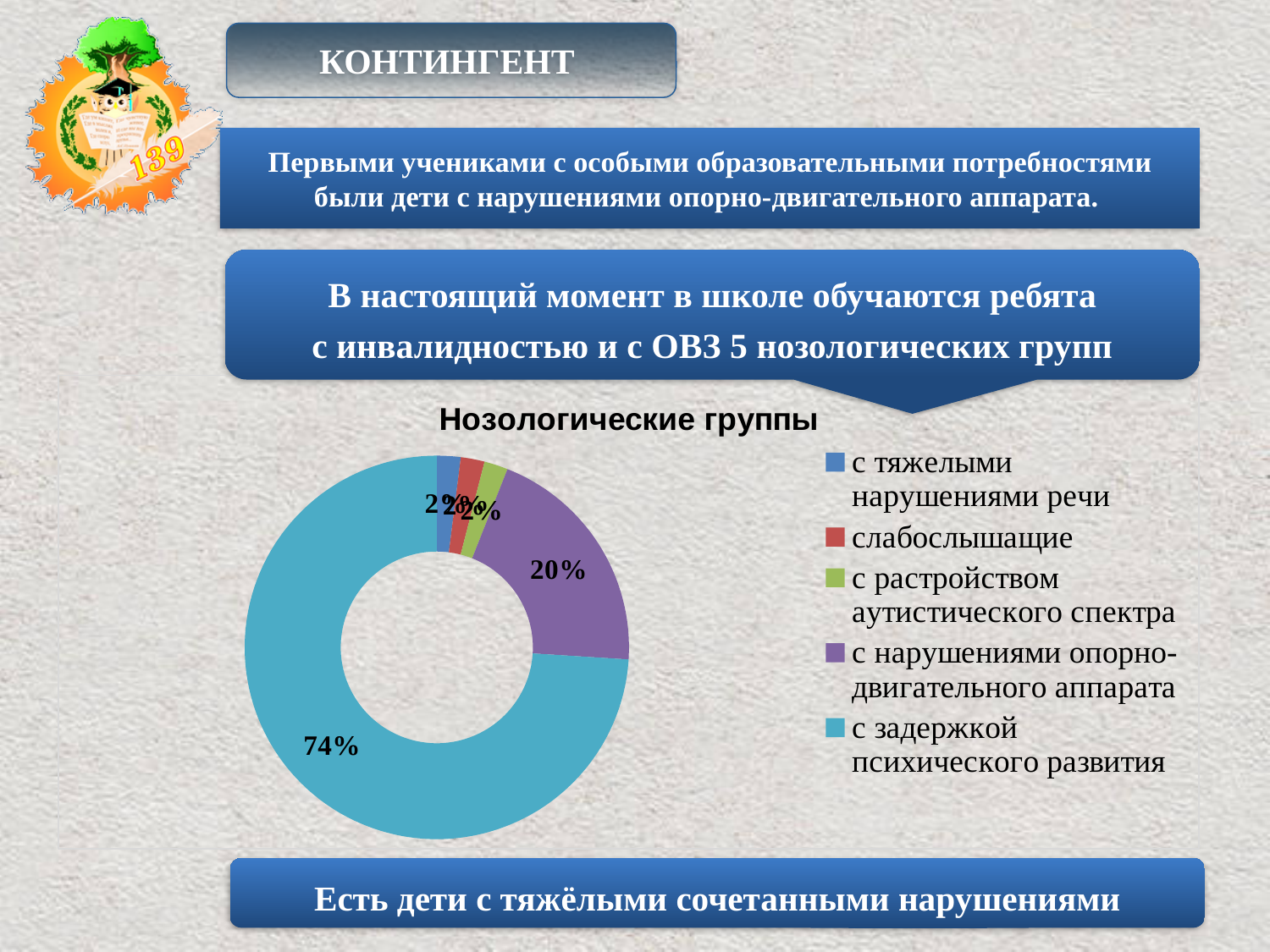
Which category is represented by the purple slice? с нарушениями опорно-двигательного аппарата Which category has the largest share of the chart? с задержкой психического развития What percentage is shown for 'с задержкой психического развития'? 74% Is the share for 'слабослышащие' greater or less than 10%? less Which is larger: the share for 'с задержкой психического развития' or for 'с нарушениями опорно-двигательного аппарата'? с задержкой психического развития What is the difference in percentage points between 'с задержкой психического развития' (74%) and 'с нарушениями опорно-двигательного аппарата' (20%)? 54 percentage points What kind of chart is shown on the slide? doughnut chart What is the title of the chart? Нозологические группы How many entries does the chart legend list? 5 How many categories does the chart show? 5 What share of the chart does the purple slice represent? 20% What percentage is shown for 'с нарушениями опорно-двигательного аппарата'? 20%